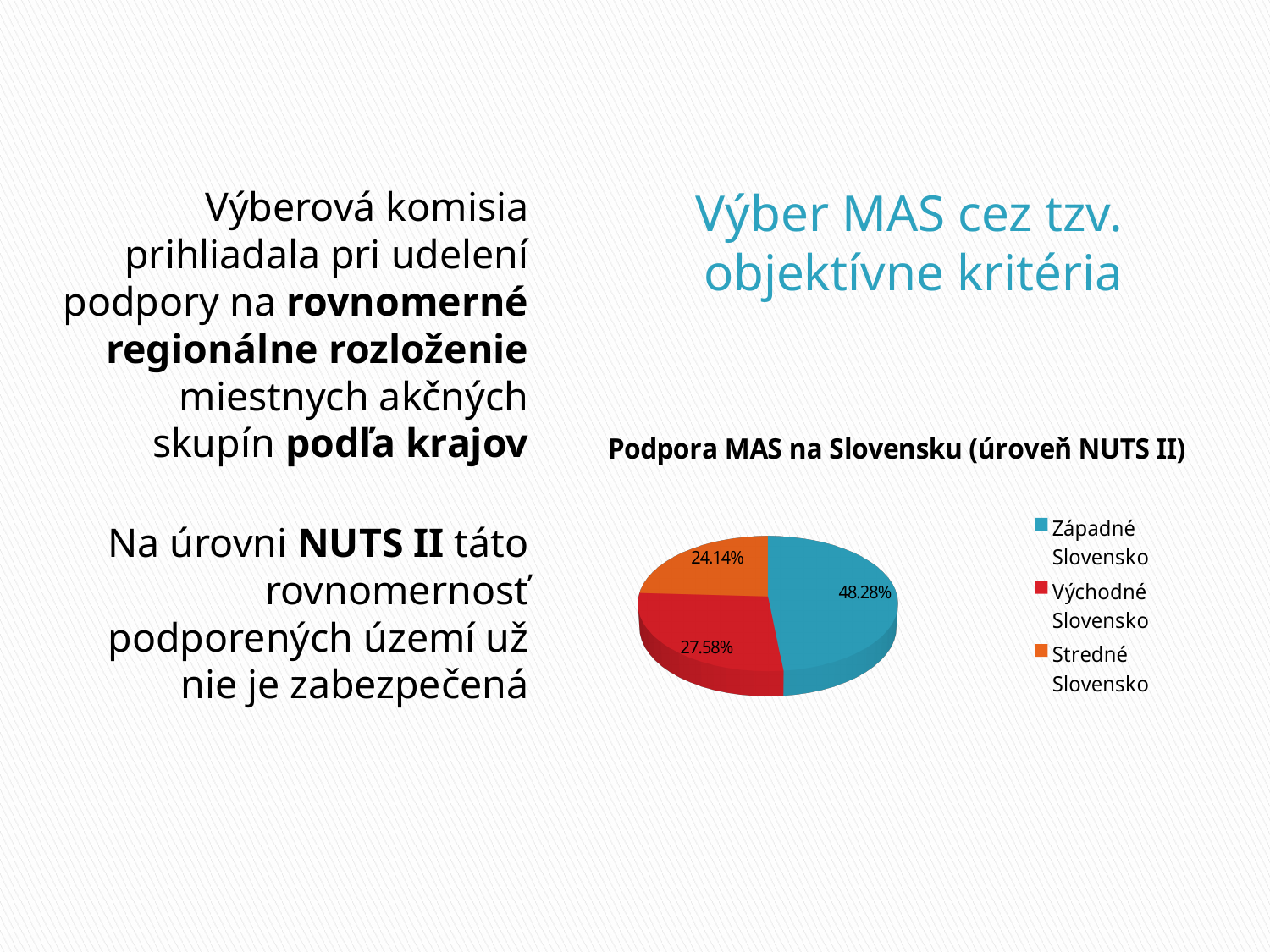
How many entries does the legend list? 3 What share of the pie does Stredné Slovensko have? 24.14% Which region has the smallest slice of the pie? Stredné Slovensko Which region has the largest slice of the pie? Západné Slovensko What is the title of the chart? Podpora MAS na Slovensku (úroveň NUTS II) Which is larger, the share for Východné Slovensko or the share for Stredné Slovensko? Východné Slovensko What share of the pie does Západné Slovensko have? 48.28% What type of chart is shown on the slide? pie chart What is the difference between the shares of Západné Slovensko and Východné Slovensko? 20.70% Which colour represents Stredné Slovensko in the pie chart? orange How many slices does the pie chart have? 3 What share of the pie does Východné Slovensko have? 27.58%